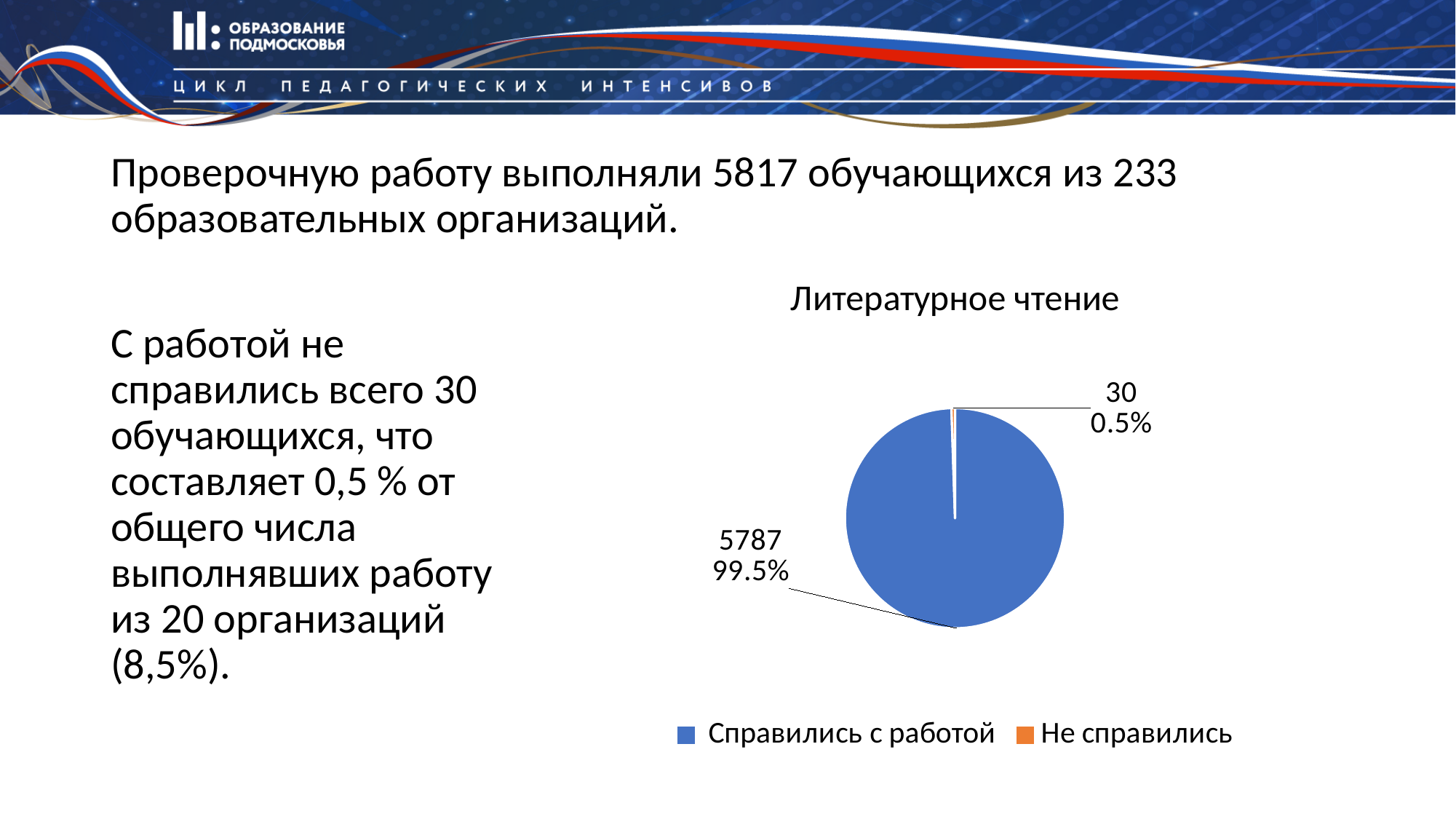
What type of chart is shown on the slide? pie chart How many series does the legend list? 2 What is the value for "Не справились"? 30 Which category has the largest slice? Справились с работой What is the value for "Справились с работой"? 5787 How many slices does the pie chart have? 2 Which category has the smallest slice? Не справились What share of the pie does "Справились с работой" represent? 99.5% What is the difference between the values for "Справились с работой" and "Не справились"? 5757 What share of the pie does "Не справились" represent? 0.5% Which colour represents "Не справились" in the chart? orange What is the title of the chart? Литературное чтение